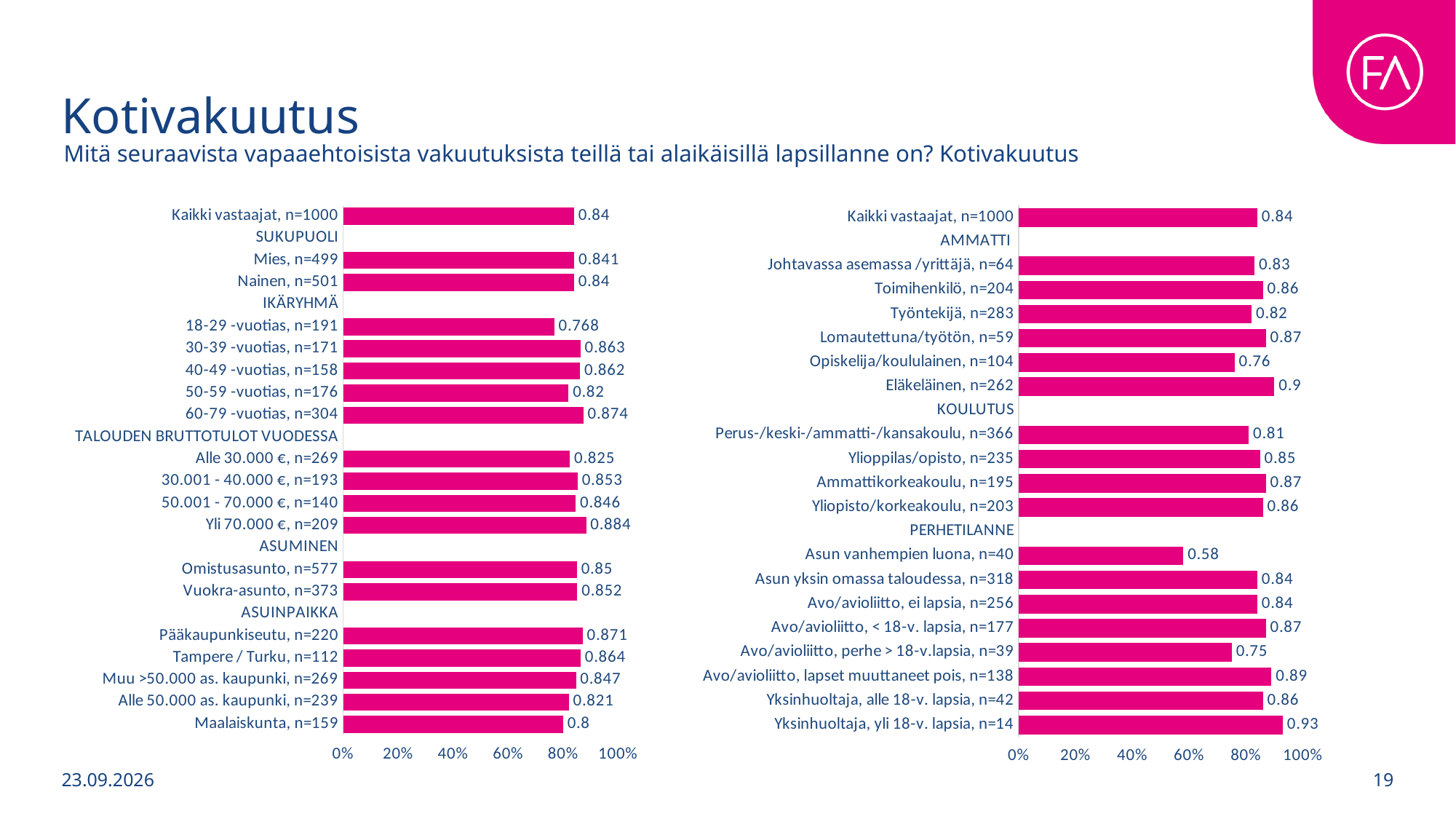
On the right chart, what is the value for Eläkeläinen, n=262? 0.9 On the right chart, is the value for Asun vanhempien luona, n=40 greater or less than 60%? less On the right chart, which category has the lowest value? Asun vanhempien luona, n=40 On the left chart, what is the value for 18-29 -vuotias, n=191? 0.768 On the right chart, which category has the highest value? Yksinhuoltaja, yli 18-v. lapsia, n=14 On the left chart, which category has the lowest value? 18-29 -vuotias, n=191 On the left chart, which is larger: the value for Pääkaupunkiseutu, n=220 or the value for Maalaiskunta, n=159? Pääkaupunkiseutu, n=220 On the right chart, what is the value for Opiskelija/koululainen, n=104? 0.76 On the left chart, which category has the highest value? Yli 70.000 €, n=209 On the left chart, what is the value for Yli 70.000 €, n=209? 0.884 What kind of chart is shown on the left side of the slide? Bar chart On the right chart, what is the difference between the values for Yksinhuoltaja, yli 18-v. lapsia, n=14 and Asun vanhempien luona, n=40? 0.35